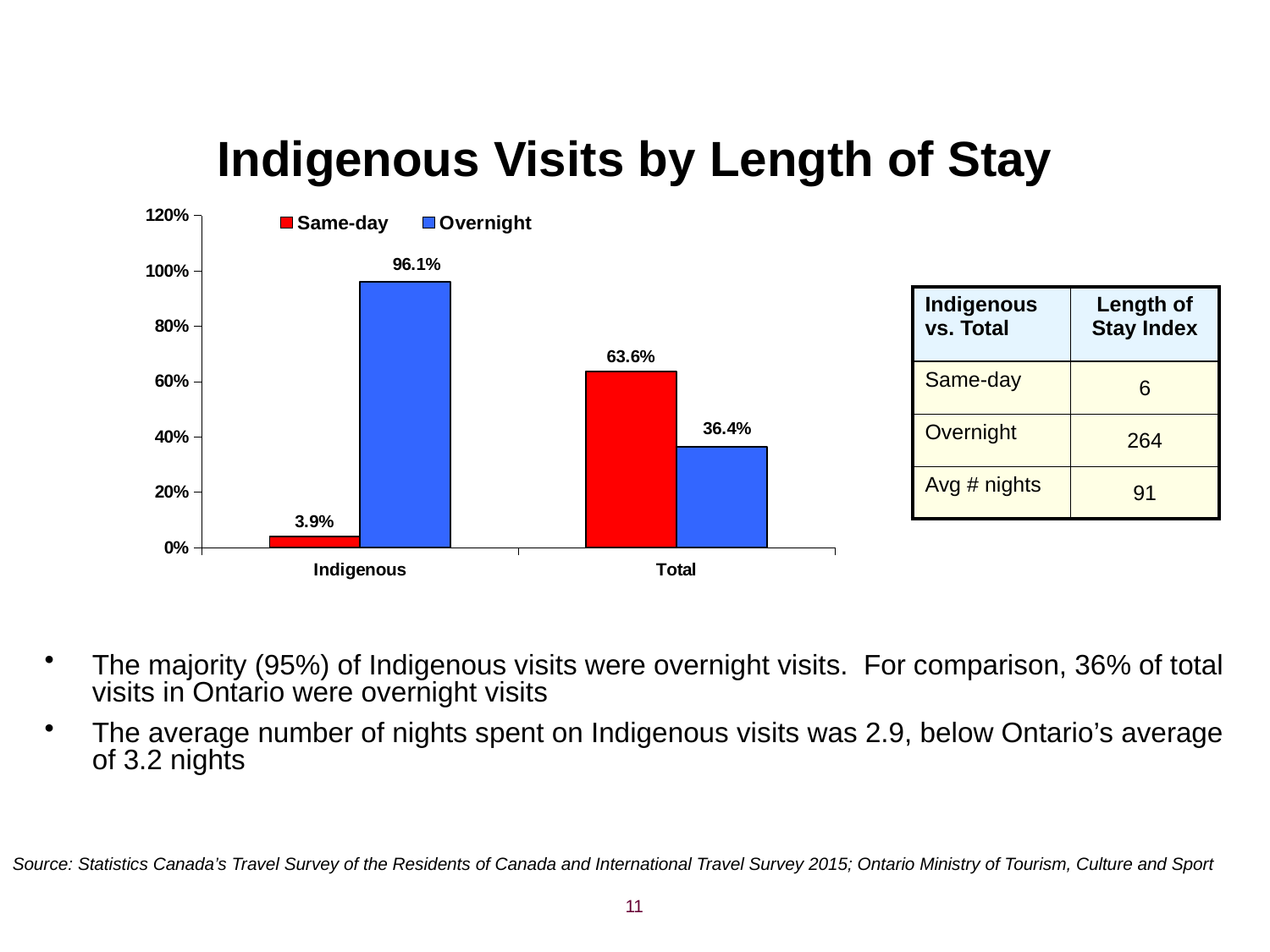
What is the Same-day value for Total? 63.6% How many categories are shown on the x axis? 2 How many series does the legend list? 2 What is the Same-day value for Indigenous? 3.9% What is the Overnight value for Indigenous? 96.1% Which category has the highest Overnight value? Indigenous What is the Overnight value for Total? 36.4% Which is larger for Total: Same-day or Overnight? Same-day Which category has the lowest Same-day value? Indigenous What colour represents the Overnight series? blue What is the difference between the Overnight values for Indigenous and Total? 59.7% What kind of chart is shown? bar chart